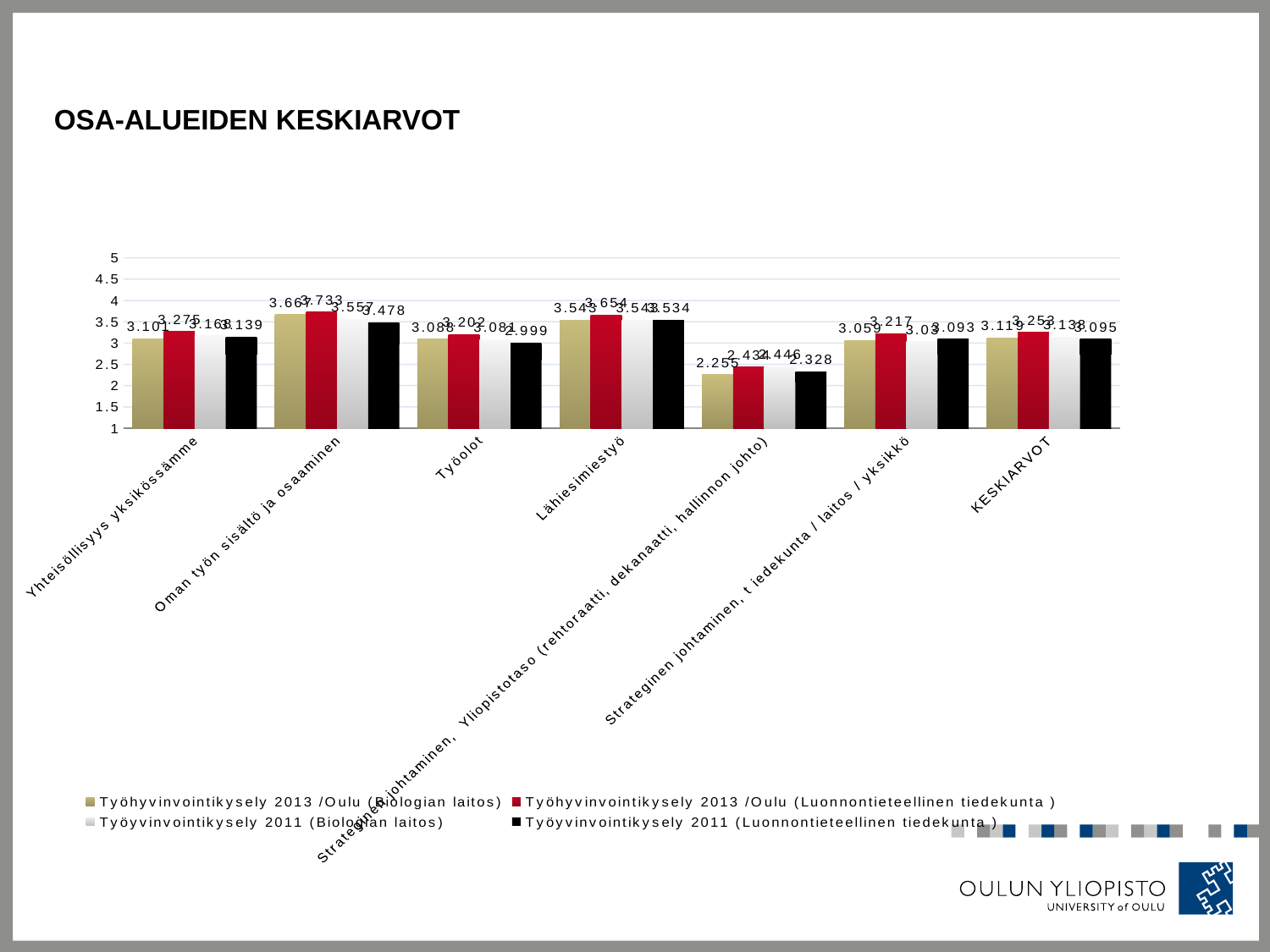
How many series does the legend list? 4 What is the value for Työhyvinvointikysely 2013 /Oulu (Biologian laitos) in the category Strateginen johtaminen, Yliopistotaso (rehtoraatti, dekanaatti, hallinnon johto)? 2.255 What is the value for Työyvinvointikysely 2011 (Luonnontieteellinen tiedekunta) in the category Työolot? 2.999 What is the value for Työyvinvointikysely 2011 (Luonnontieteellinen tiedekunta) in the category Oman työn sisältö ja osaaminen? 3.478 In the category Strateginen johtaminen, Yliopistotaso (rehtoraatti, dekanaatti, hallinnon johto), what is the difference between Työyvinvointikysely 2011 (Luonnontieteellinen tiedekunta) and Työhyvinvointikysely 2013 /Oulu (Biologian laitos)? 0.073 Which category has the highest values across all series? Oman työn sisältö ja osaaminen What is the title of the chart? OSA-ALUEIDEN KESKIARVOT What kind of chart is shown on the slide? bar chart What is the value for Työhyvinvointikysely 2013 /Oulu (Luonnontieteellinen tiedekunta) in the category Lähiesimiestyö? 3.654 Is the value for Työhyvinvointikysely 2013 /Oulu (Luonnontieteellinen tiedekunta) in the category Strateginen johtaminen, Yliopistotaso (rehtoraatti, dekanaatti, hallinnon johto) greater or less than 3? less Which category has the lowest values across all series? Strateginen johtaminen, Yliopistotaso (rehtoraatti, dekanaatti, hallinnon johto) How many categories are shown on the x axis? 7